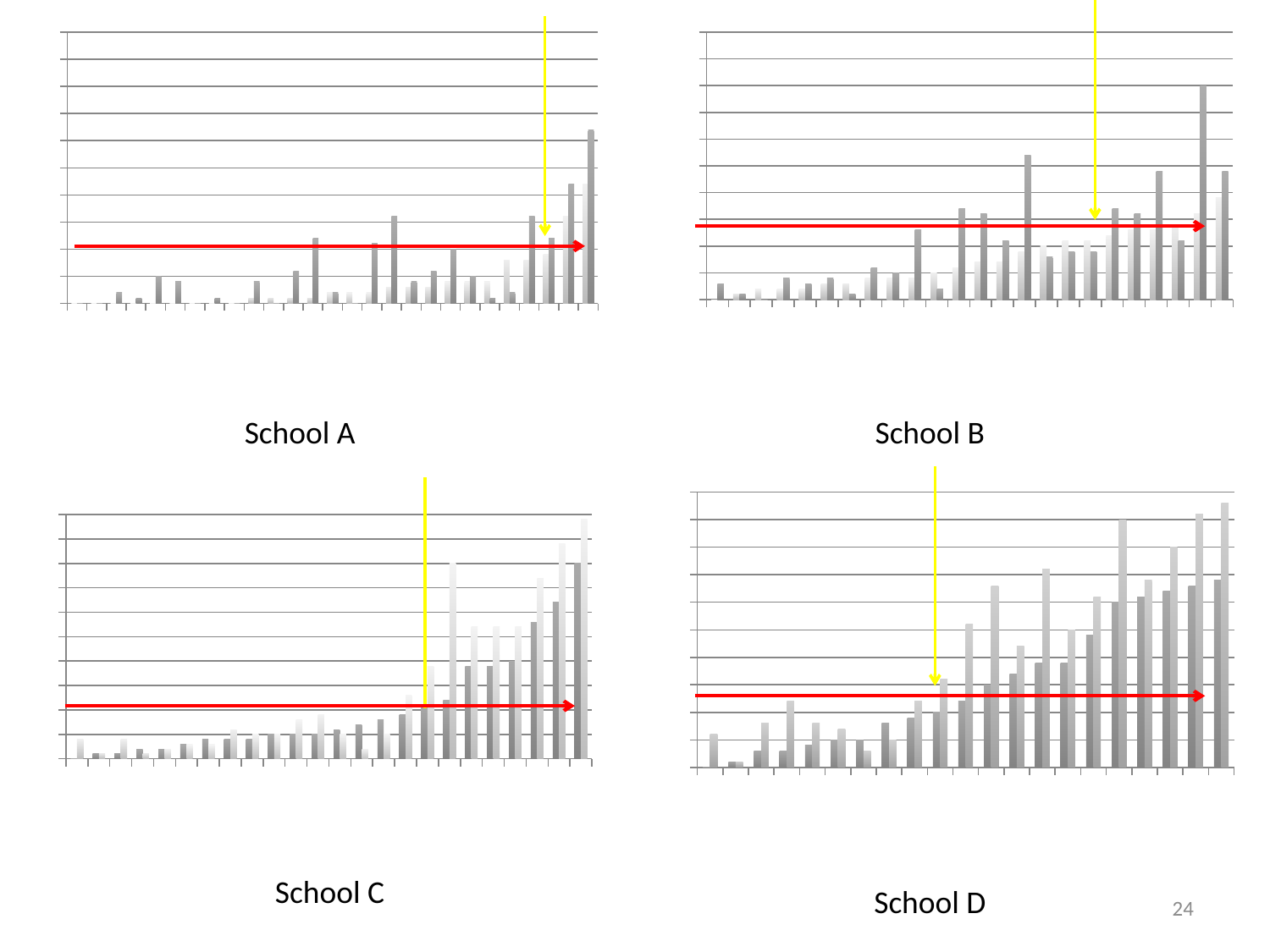
Which school's chart is in the bottom-right position on the slide? School D How many charts are shown on the slide? 4 In the School C chart, do the bar values generally rise or fall from left to right along the x axis? rise What kind of chart is shown for School C? bar chart What kind of chart is shown for School A? bar chart In the School A chart, do the bar values generally rise or fall from left to right along the x axis? rise What colour is the horizontal arrow drawn across each chart? red In the School D chart, do the bar values generally rise or fall from left to right along the x axis? rise